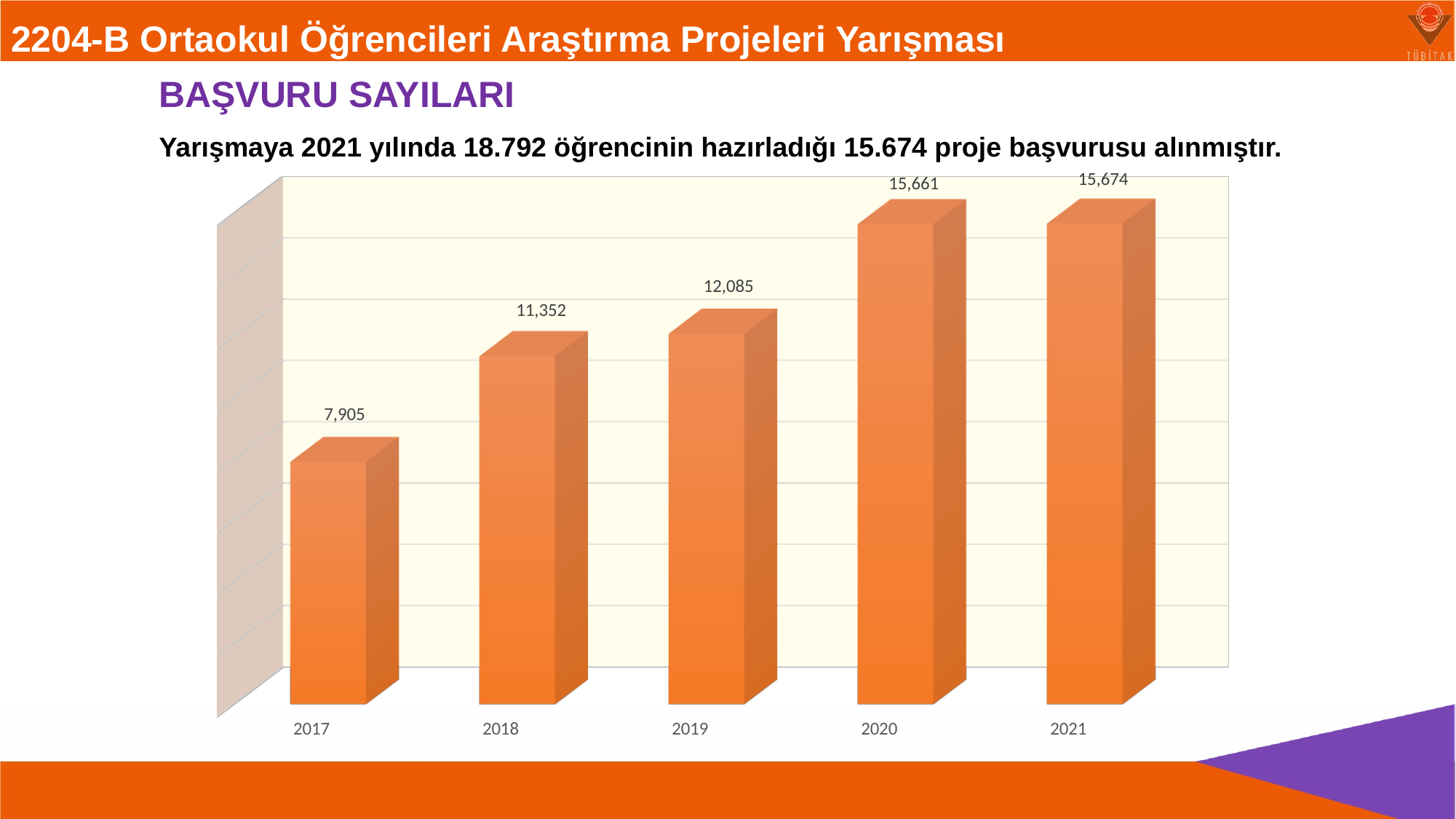
What is the value for 2017? 7,905 Which year has the highest value? 2021 Which year has the lowest value? 2017 What is the value for 2020? 15,661 What is the value for 2019? 12,085 What is the difference between the values for 2018 and 2017? 3,447 What is the difference between the values for 2021 and 2020? 13 What is the value for 2021? 15,674 What is the value for 2018? 11,352 How many years are shown on the x axis? 5 Which is larger, the value for 2019 or the value for 2018? 2019 What kind of chart is shown on the slide? Bar chart